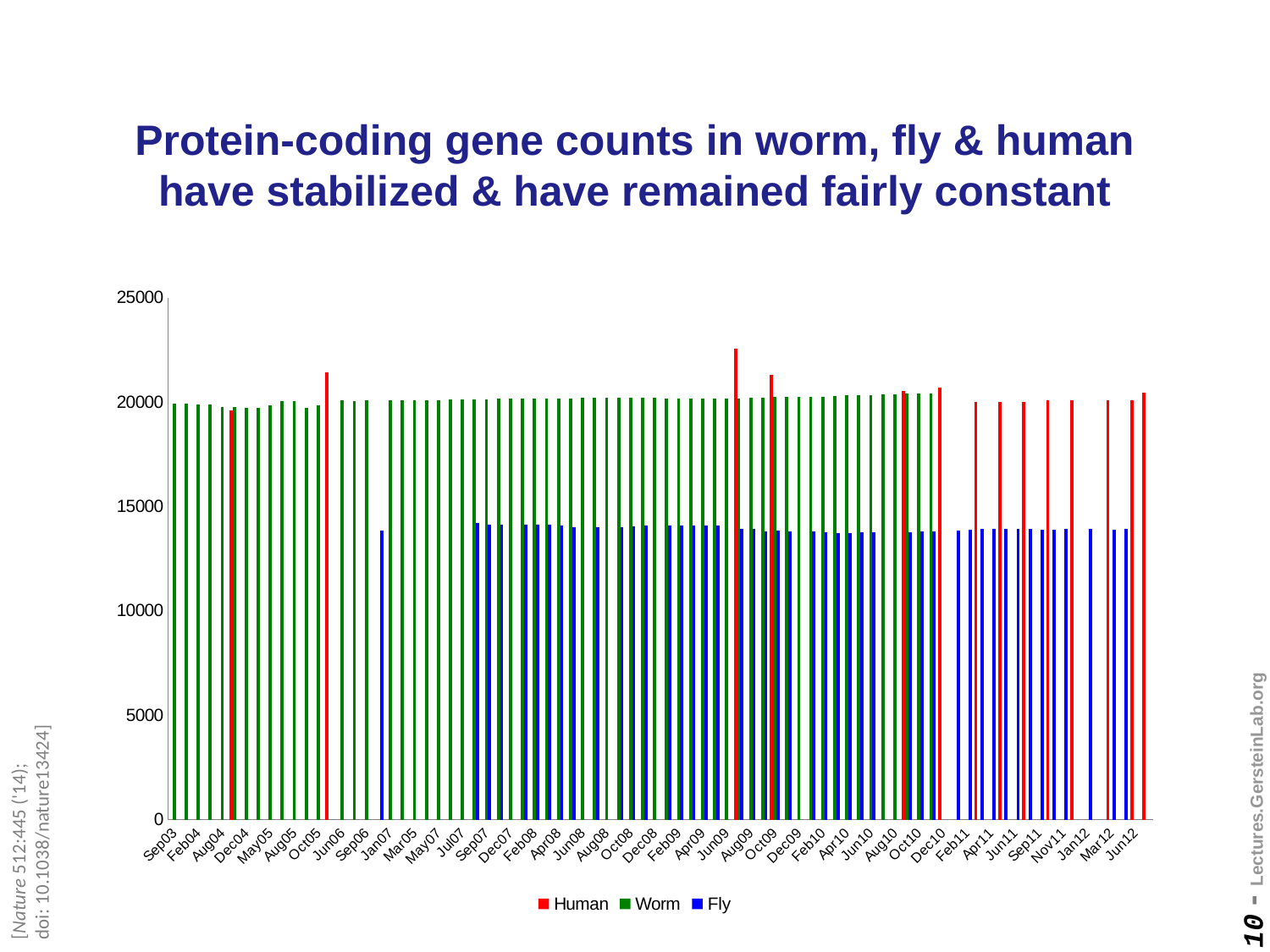
Which series has the lowest values throughout the chart? Fly Which series reaches the highest value on the chart? Human How many series does the legend list? 3 Which is larger at Feb08, the Worm value or the Fly value? Worm What kind of chart is shown on the slide? bar chart What colour represents the Fly series? blue Which series are listed in the legend? Human, Worm, Fly Is the Worm value for Sep03 greater or less than 15000? greater